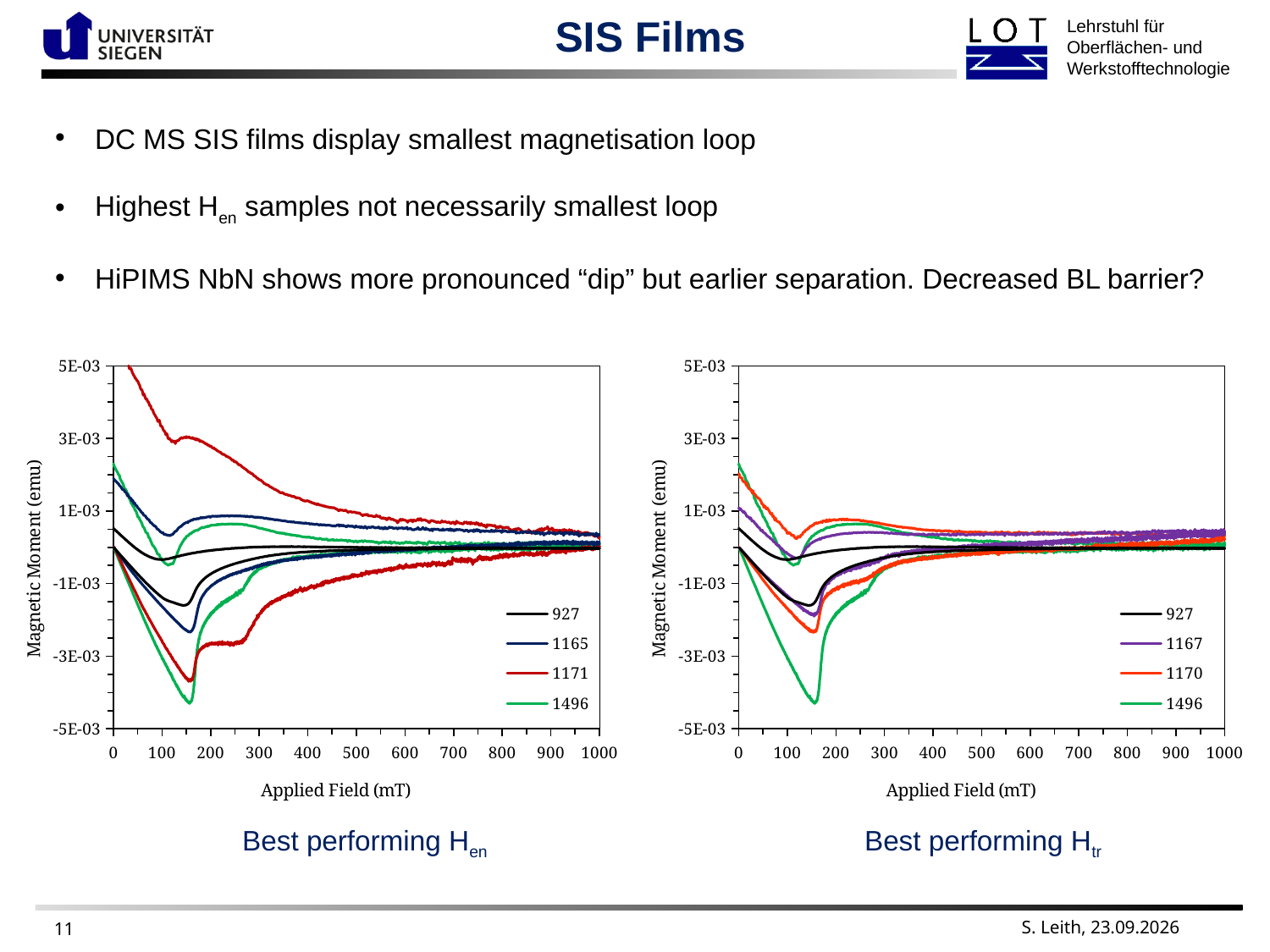
In the left chart (Best performing Hen), is the lowest value reached by series 1496 greater or less than -3E-03? less What is the maximum value shown on the x axis of the right chart (Best performing Htr)? 1000 How many series does the legend of the left chart (Best performing Hen) list? 4 In the left chart (Best performing Hen), is the lowest value reached by series 927 greater or less than -3E-03? greater What kind of chart is the left chart, labelled "Best performing Hen"? line chart In the right chart (Best performing Htr), which series does the legend list in purple? 1167 What is the x-axis label of the left chart (Best performing Hen)? Applied Field (mT) How many series does the legend of the right chart (Best performing Htr) list? 4 In the right chart (Best performing Htr), is the lowest value reached by series 927 greater or less than -3E-03? greater In the right chart (Best performing Htr), which series reaches the lowest magnetic moment? 1496